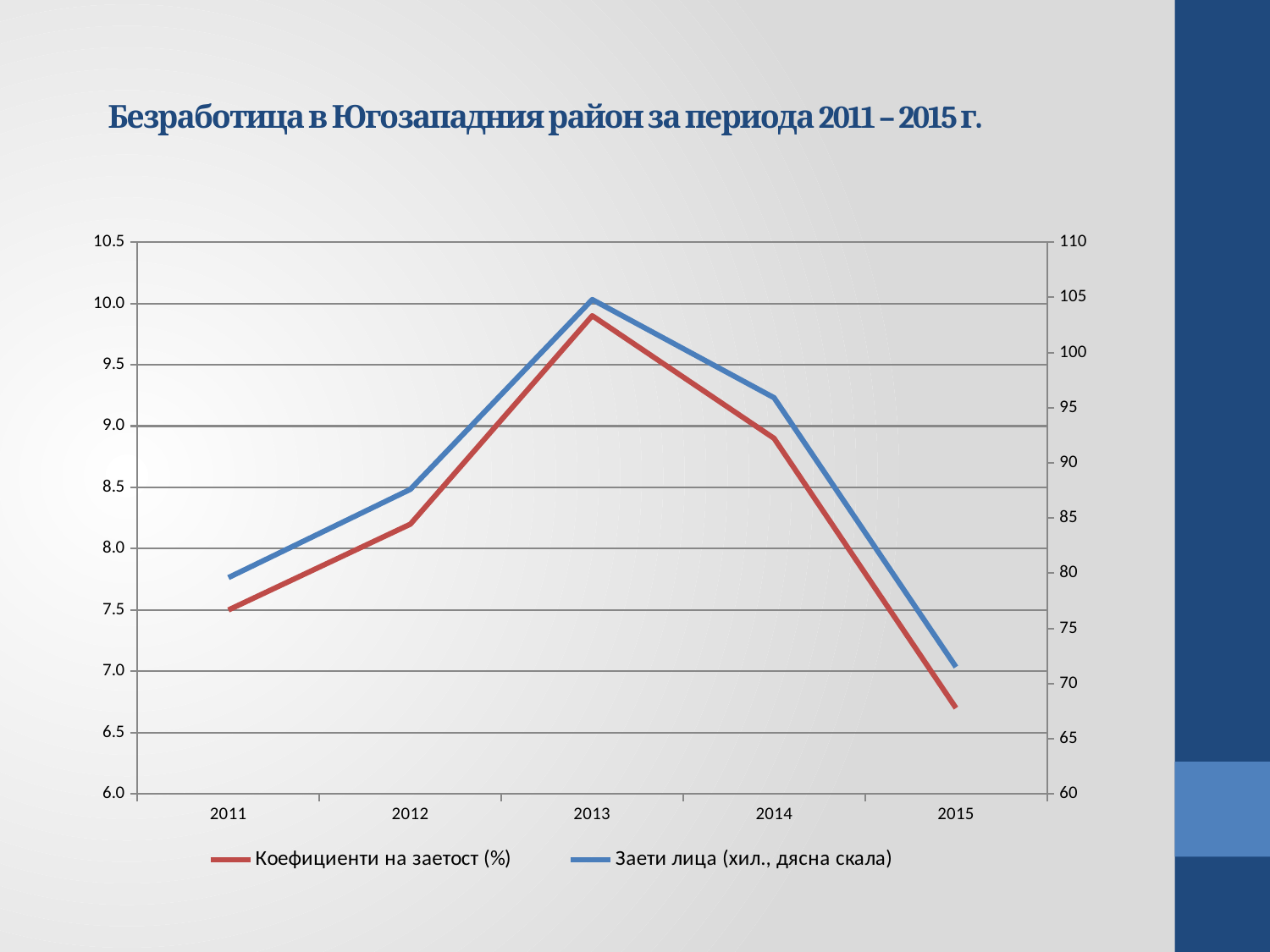
Is the value of 'Коефициенти на заетост (%)' in 2012 greater or less than 8.0? greater Is the value of 'Заети лица (хил., дясна скала)' in 2013 greater or less than 100 on the right-hand scale? greater What kind of chart is shown on the slide? line chart Is the value of 'Заети лица (хил., дясна скала)' in 2015 greater or less than 75 on the right-hand scale? less In which year does the series 'Коефициенти на заетост (%)' reach its lowest value? 2015 In which year does the series 'Заети лица (хил., дясна скала)' reach its highest value? 2013 Which series is drawn in red? Коефициенти на заетост (%) How many years are plotted along the x axis? 5 Does the series 'Коефициенти на заетост (%)' rise or fall from 2013 to 2015? fall How many series does the legend list? 2 In which year does the series 'Коефициенти на заетост (%)' reach its highest value? 2013